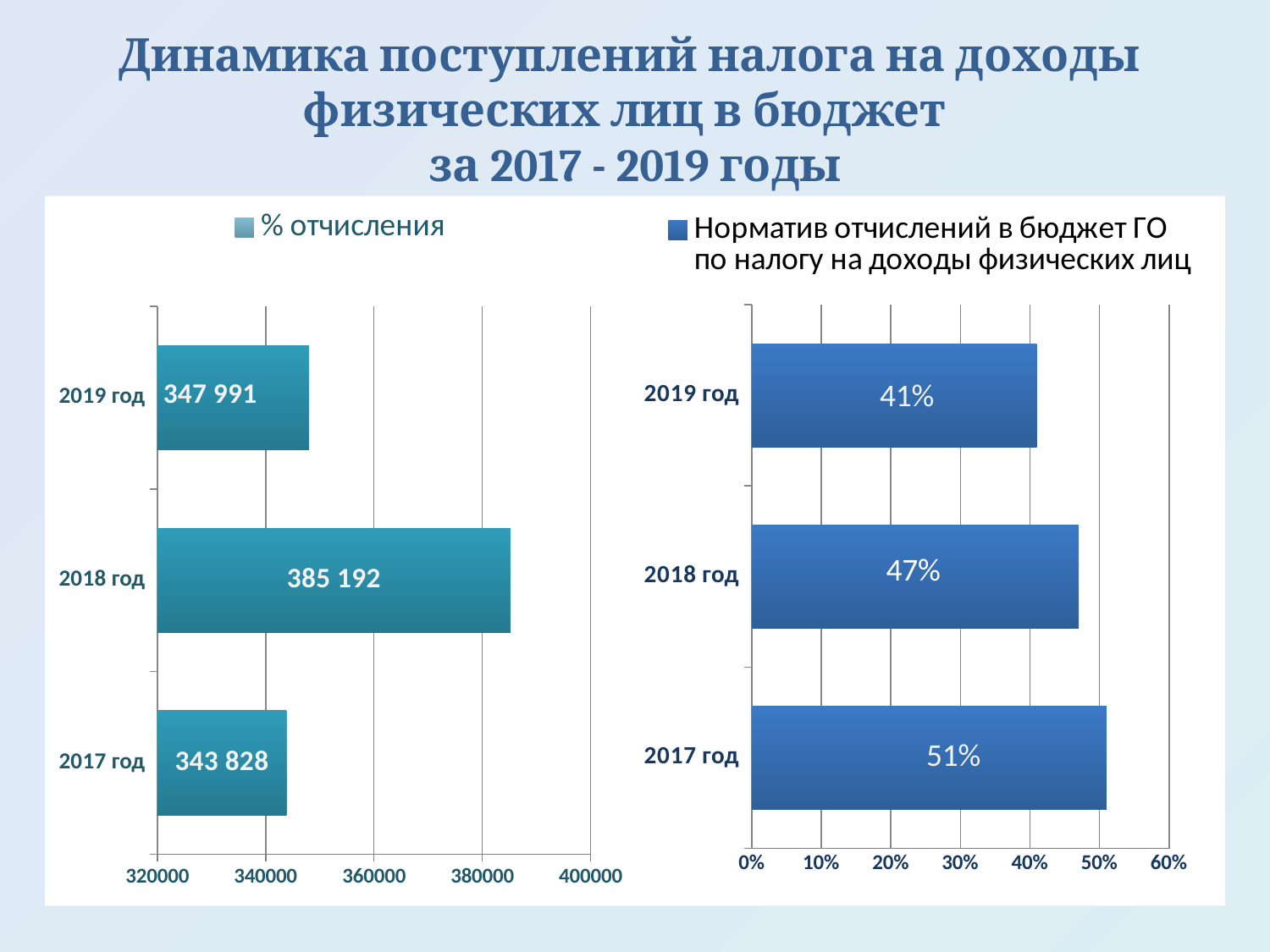
In the right chart, which year has the lowest value? 2019 год In the left chart, which is larger: the value for 2019 год or 2017 год? 2019 год In the left chart, what is the difference between the values for 2018 год and 2019 год? 37 201 In the left chart, what is the value for 2018 год? 385 192 In the right chart, what is the value for 2017 год? 51% In the right chart, what is the difference between the values for 2017 год and 2019 год? 10% In the left chart, what is the value for 2017 год? 343 828 In the right chart, what is the value for 2019 год? 41% How many bars does the right chart have? 3 In the left chart, which year has the highest value? 2018 год In the right chart, do the values rise or fall from 2017 год to 2019 год? fall What type of chart is the left chart? bar chart